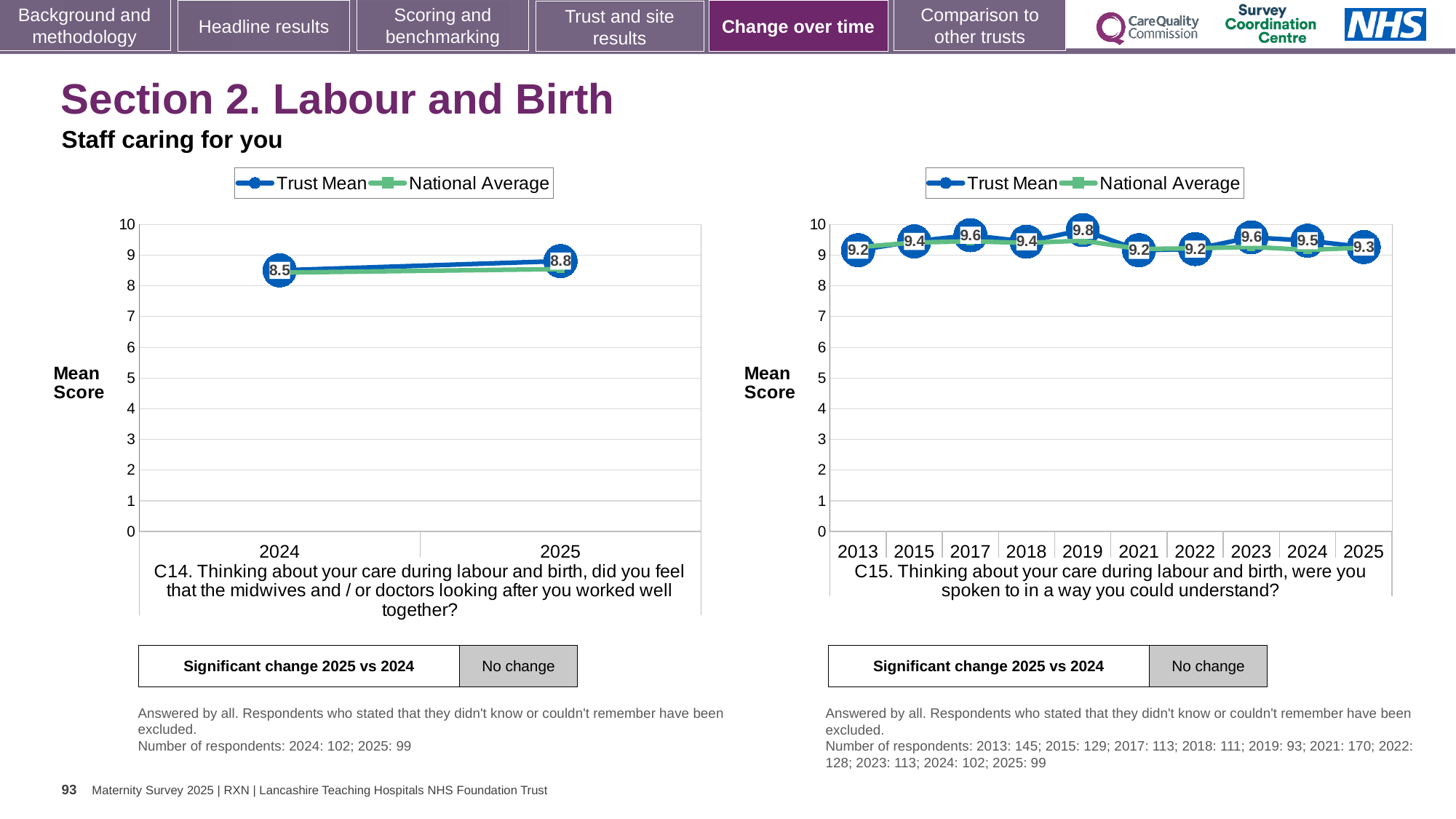
In the right chart (C15), what is the Trust Mean for 2019? 9.8 In the right chart (C15), what is the difference between the Trust Mean in 2019 and in 2021? 0.6 What type of chart is the right chart (C15)? line chart In the left chart (C14), what is the Trust Mean for 2024? 8.5 In the right chart (C15), what is the Trust Mean for 2025? 9.3 In the right chart (C15), which year has the highest Trust Mean? 2019 In the left chart (C14), does the Trust Mean rise or fall from 2024 to 2025? rise In the right chart (C15), how many years are plotted on the x axis? 10 How many series does the legend of the left chart (C14) list? 2 In the right chart (C15), is the Trust Mean for 2023 larger or smaller than the Trust Mean for 2022? larger In the left chart (C14), by how much did the Trust Mean change from 2024 to 2025? 0.3 In the left chart (C14), what is the Trust Mean for 2025? 8.8